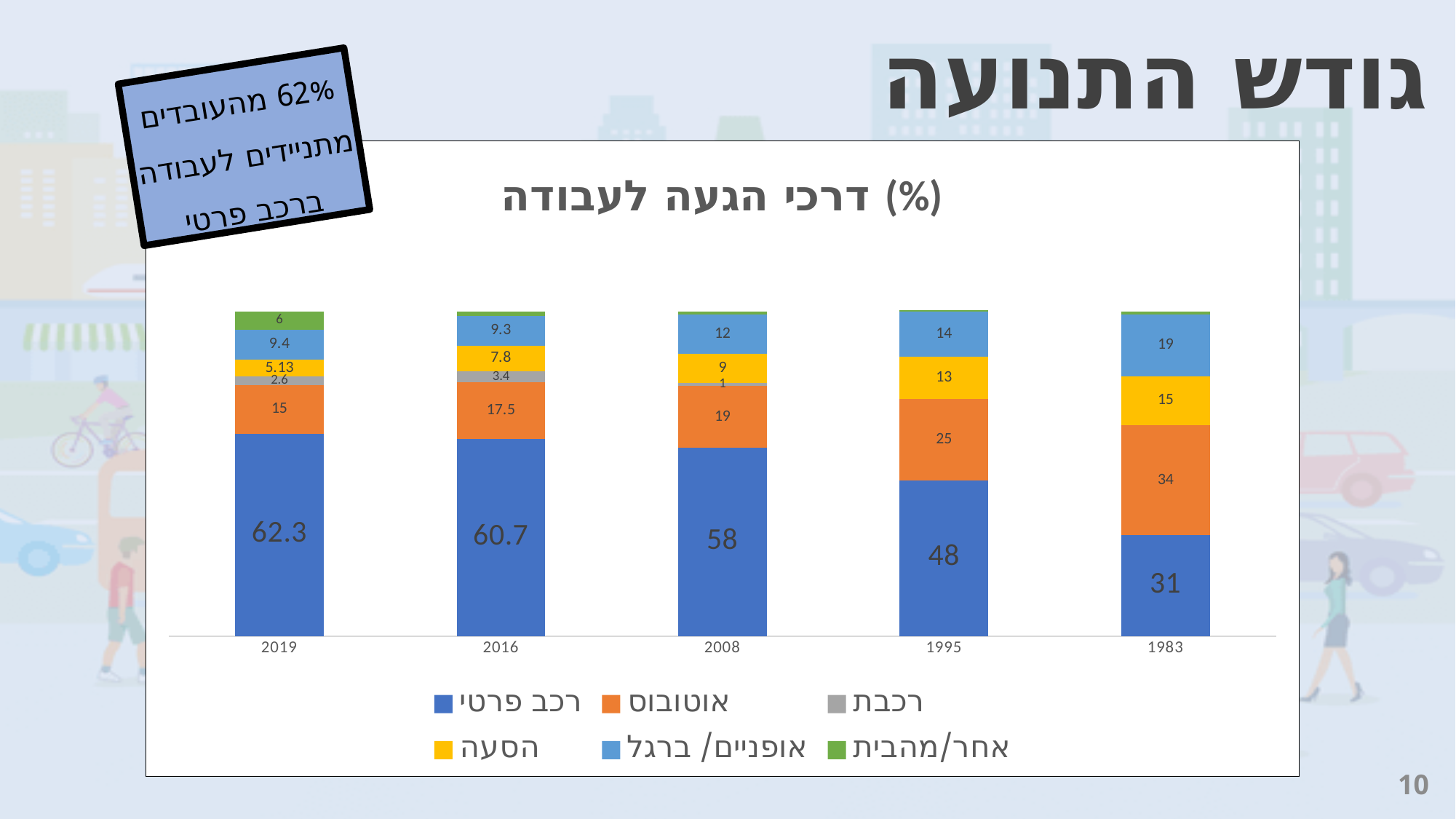
What is the value for הסעה in 1995? 13 How many series does the legend list? 6 What is the value for אופניים/ברגל in 2008? 12 How many years are shown on the x axis? 5 What is the difference between the רכב פרטי values for 2019 and 1983? 31.3 In which year is the רכב פרטי value highest? 2019 What is the value for אוטובוס in 1983? 34 What is the value for רכבת in 2016? 3.4 What kind of chart is shown? Stacked bar chart In which year is the רכב פרטי value lowest? 1983 What is the value for רכב פרטי in 2019? 62.3 In 1983, which is larger: אוטובוס or רכב פרטי? אוטובוס